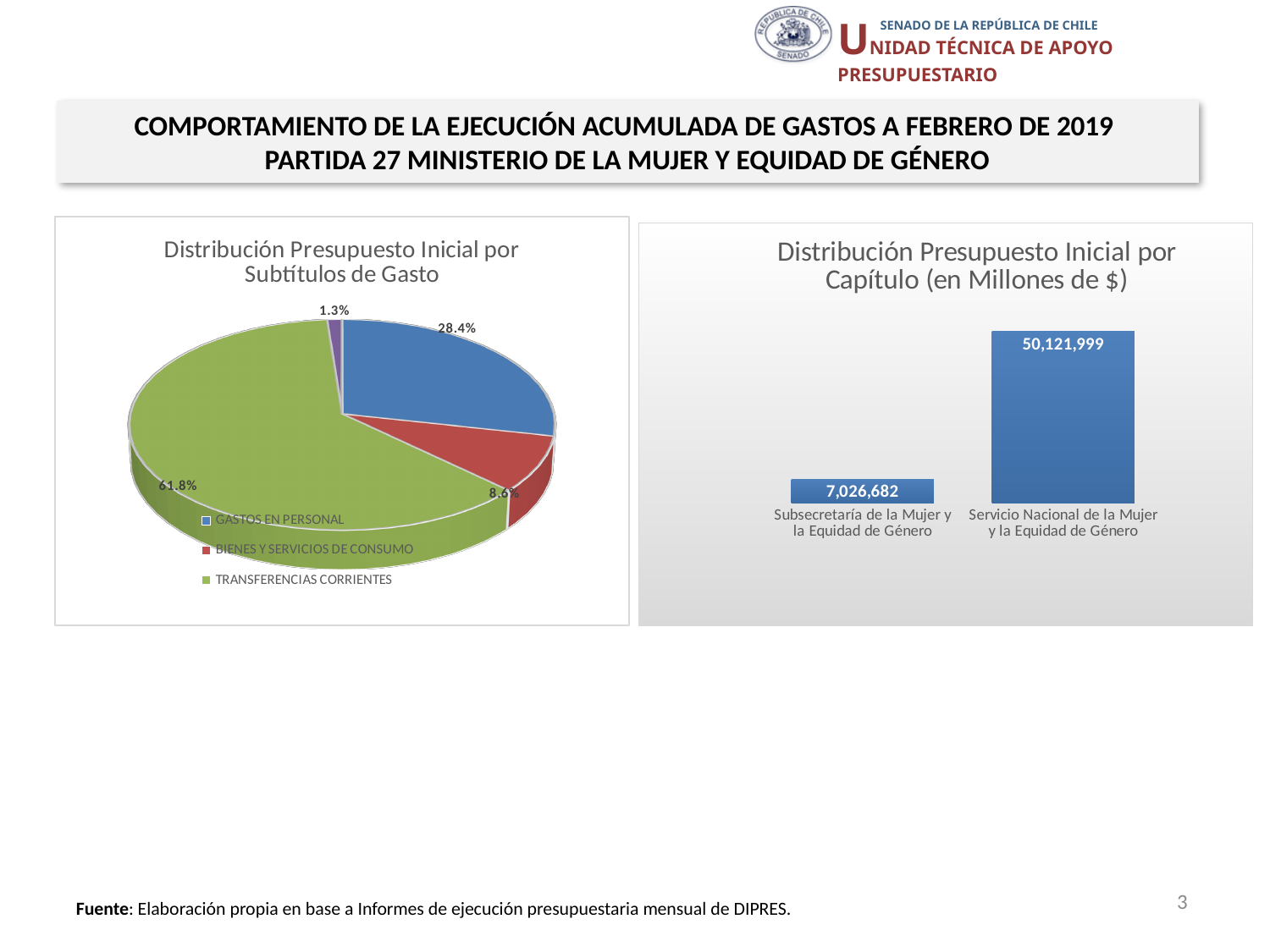
In the pie chart on the left, what is the difference in percentage points between TRANSFERENCIAS CORRIENTES and GASTOS EN PERSONAL? 33.4 In the chart 'Distribución Presupuesto Inicial por Capítulo (en Millones de $)', what is the value for Servicio Nacional de la Mujer y la Equidad de Género? 50,121,999 In the pie chart on the left, which legend category has the largest share? TRANSFERENCIAS CORRIENTES What kind of chart is the chart on the right, 'Distribución Presupuesto Inicial por Capítulo'? Bar chart How many categories are shown in the bar chart on the right? 2 In the pie chart 'Distribución Presupuesto Inicial por Subtítulos de Gasto', what share does TRANSFERENCIAS CORRIENTES have? 61.8% In the chart 'Distribución Presupuesto Inicial por Capítulo (en Millones de $)', what is the value for Subsecretaría de la Mujer y la Equidad de Género? 7,026,682 In the pie chart 'Distribución Presupuesto Inicial por Subtítulos de Gasto', what share does BIENES Y SERVICIOS DE CONSUMO have? 8.6% In the chart on the right, what is the difference between the Servicio Nacional and the Subsecretaría values? 43,095,317 In the pie chart on the left, which is larger: GASTOS EN PERSONAL or BIENES Y SERVICIOS DE CONSUMO? GASTOS EN PERSONAL In the pie chart on the left, how many entries does the legend list? 3 In the pie chart 'Distribución Presupuesto Inicial por Subtítulos de Gasto', what share does GASTOS EN PERSONAL have? 28.4%